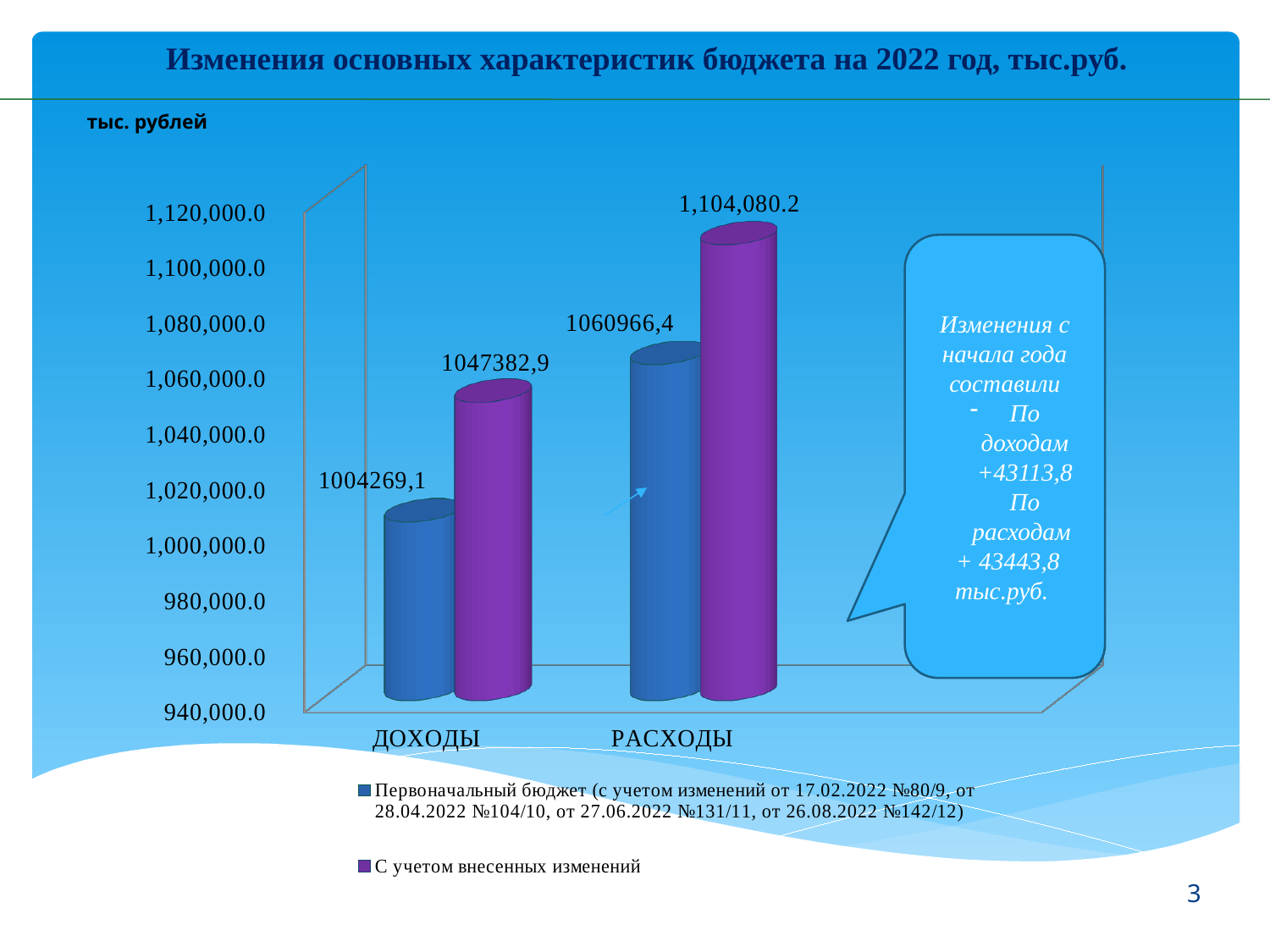
Which is larger: the 'Первоначальный бюджет' value for РАСХОДЫ or the 'С учетом внесенных изменений' value for ДОХОДЫ? Первоначальный бюджет for РАСХОДЫ How many categories are shown on the x axis of the chart? 2 Which bar in the chart has the lowest value? ДОХОДЫ, Первоначальный бюджет What is the value of the 'Первоначальный бюджет' series for ДОХОДЫ? 1004269,1 By how much does the 'С учетом внесенных изменений' value for ДОХОДЫ exceed the 'Первоначальный бюджет' value for ДОХОДЫ? 43113,8 What is the value of the 'С учетом внесенных изменений' series for РАСХОДЫ? 1,104,080.2 What type of chart is shown on the slide? bar chart What is the value of the 'С учетом внесенных изменений' series for ДОХОДЫ? 1047382,9 Which bar in the chart has the highest value? РАСХОДЫ, С учетом внесенных изменений What is the value of the 'Первоначальный бюджет' series for РАСХОДЫ? 1060966,4 Is the 'Первоначальный бюджет' value for ДОХОДЫ greater or less than 1,020,000.0? less How many series does the chart legend list? 2